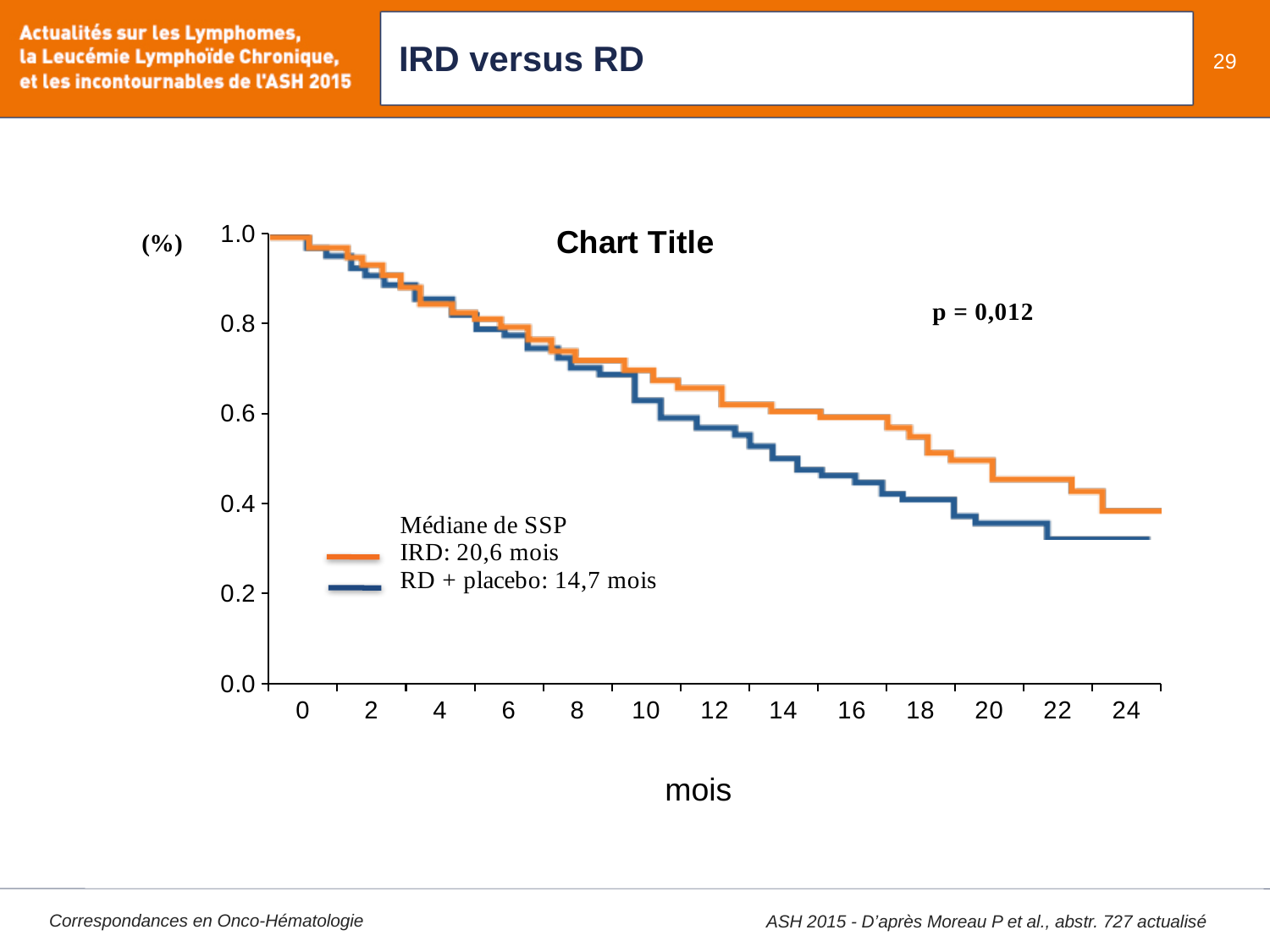
What kind of chart is shown on the slide? line chart Do the curves rise or fall as the months increase along the x axis? fall How many series does the legend list? 2 What is the difference between the median SSP of IRD and RD + placebo? 5,9 mois Is the value of the IRD curve at 12 months greater or less than 0.6? greater What p-value is shown on the chart? p = 0,012 What is the median SSP for IRD according to the legend? 20,6 mois What colour is the IRD curve? orange At 18 months, which curve is higher, IRD or RD + placebo? IRD Is the value of the RD + placebo curve at 20 months greater or less than 0.4? less What is the label of the x axis? mois What is the median SSP for RD + placebo according to the legend? 14,7 mois